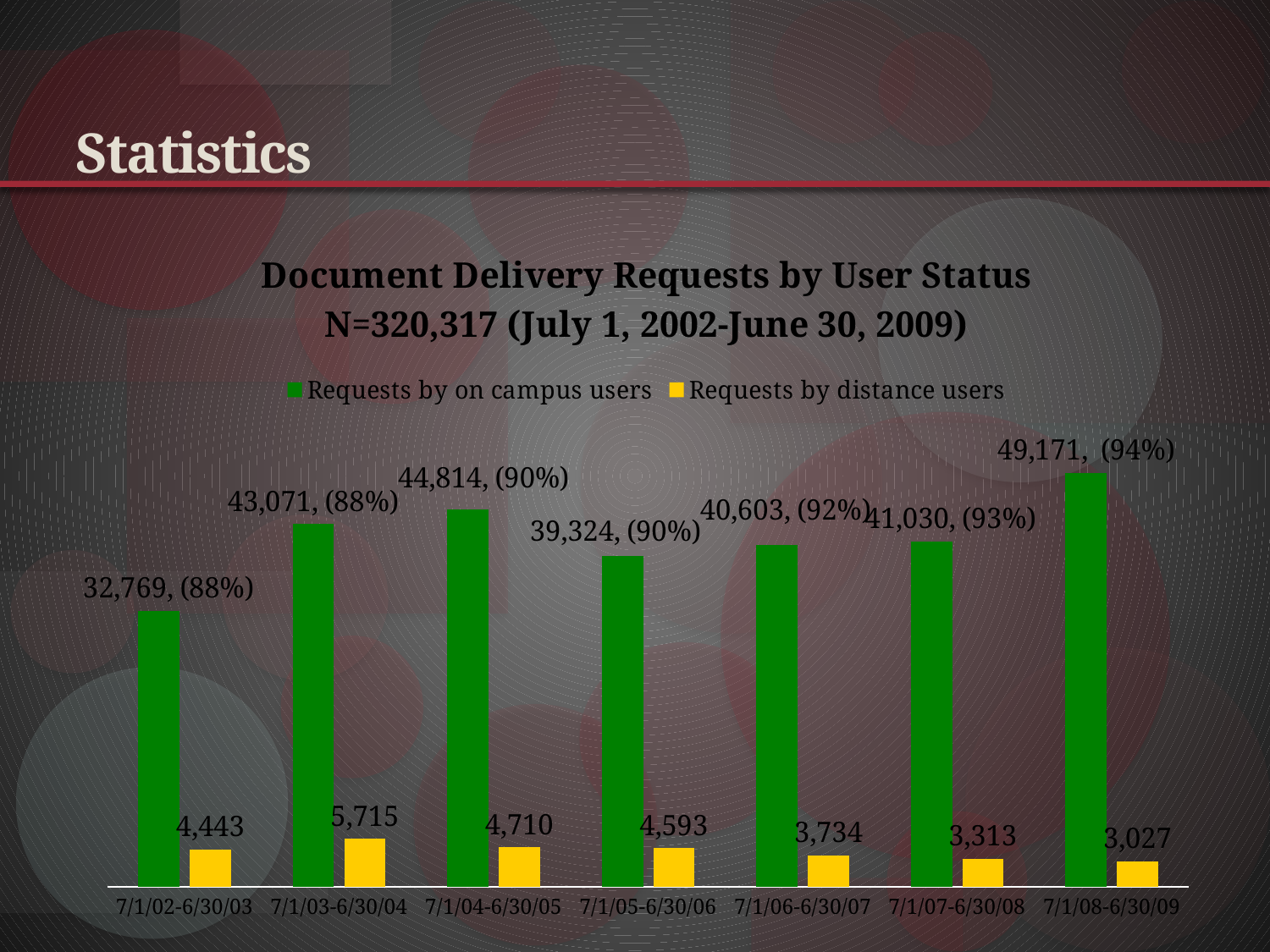
What is the difference between requests by on campus users in 7/1/04-6/30/05 and 7/1/05-6/30/06? 5,490 Which period has the highest number of requests by on campus users? 7/1/08-6/30/09 Which is larger: requests by distance users in 7/1/06-6/30/07 or in 7/1/07-6/30/08? 7/1/06-6/30/07 How many time periods are shown on the x axis? 7 Which period has the lowest number of requests by distance users? 7/1/08-6/30/09 What is the value for requests by distance users in 7/1/03-6/30/04? 5,715 What is the value for requests by on campus users in 7/1/02-6/30/03? 32,769, (88%) What kind of chart is shown on the slide? Bar chart Do requests by distance users rise or fall from 7/1/03-6/30/04 to 7/1/08-6/30/09? Fall How many series does the legend list? 2 What is the value for requests by on campus users in 7/1/08-6/30/09? 49,171, (94%) What is the title of the chart? Document Delivery Requests by User Status N=320,317 (July 1, 2002-June 30, 2009)